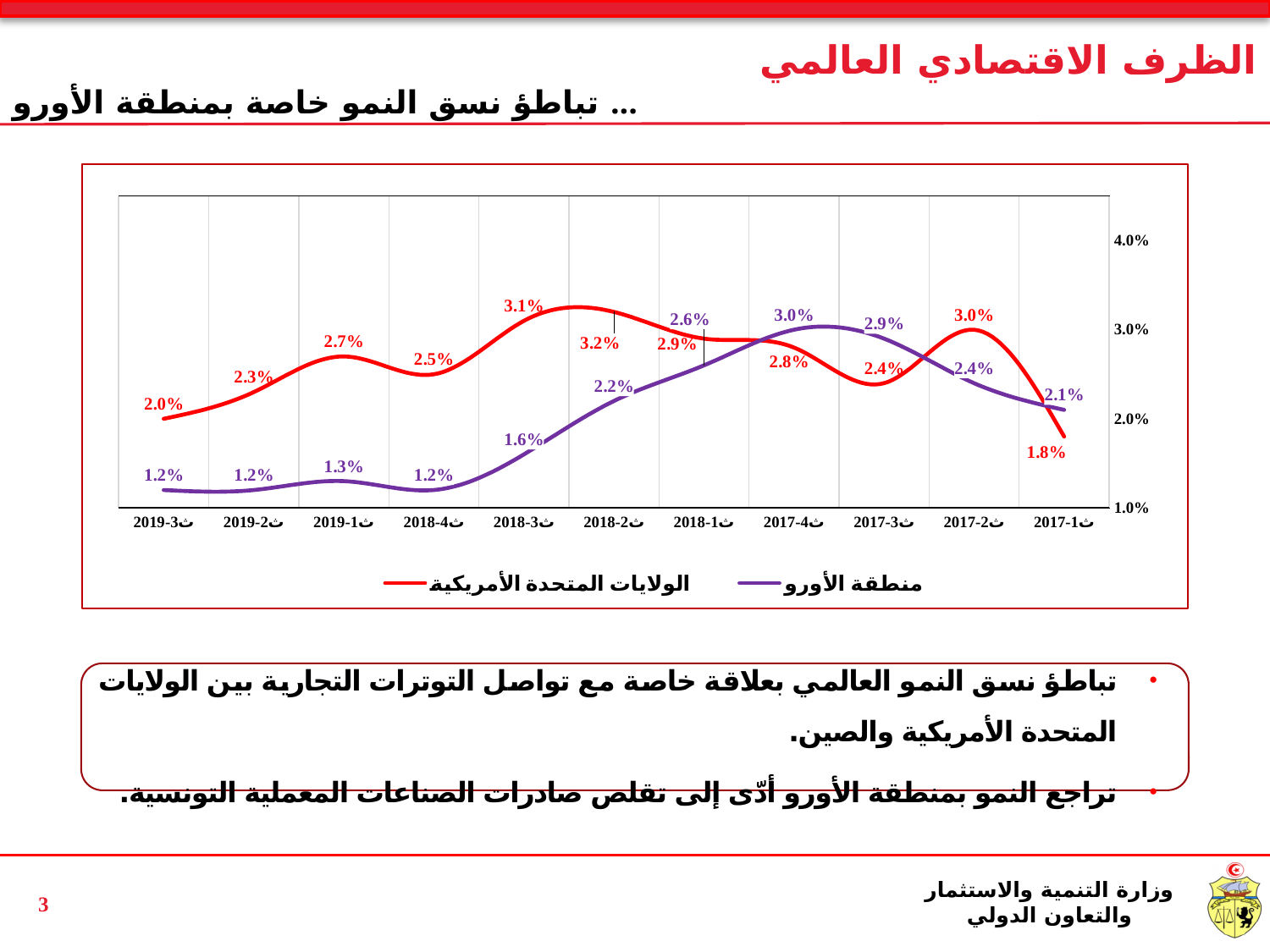
In which quarter does الولايات المتحدة الأمريكية reach its highest value? ث2-2018 Which colour is used for the الولايات المتحدة الأمريكية line? Red How many series does the chart legend list? 2 What is the value for منطقة الأورو in ث4-2017? 3.0% What is the lowest value shown for منطقة الأورو? 1.2% In ث3-2017, which series has the higher value, الولايات المتحدة الأمريكية or منطقة الأورو? منطقة الأورو What is the value for الولايات المتحدة الأمريكية in ث2-2018? 3.2% In which quarter does الولايات المتحدة الأمريكية have its lowest value? ث1-2017 What type of chart is shown on the slide? Line chart What is the difference between الولايات المتحدة الأمريكية and منطقة الأورو in ث3-2019? 0.8 percentage points What is the value for منطقة الأورو in ث3-2018? 1.6% How many quarters are plotted along the x axis of the chart? 11